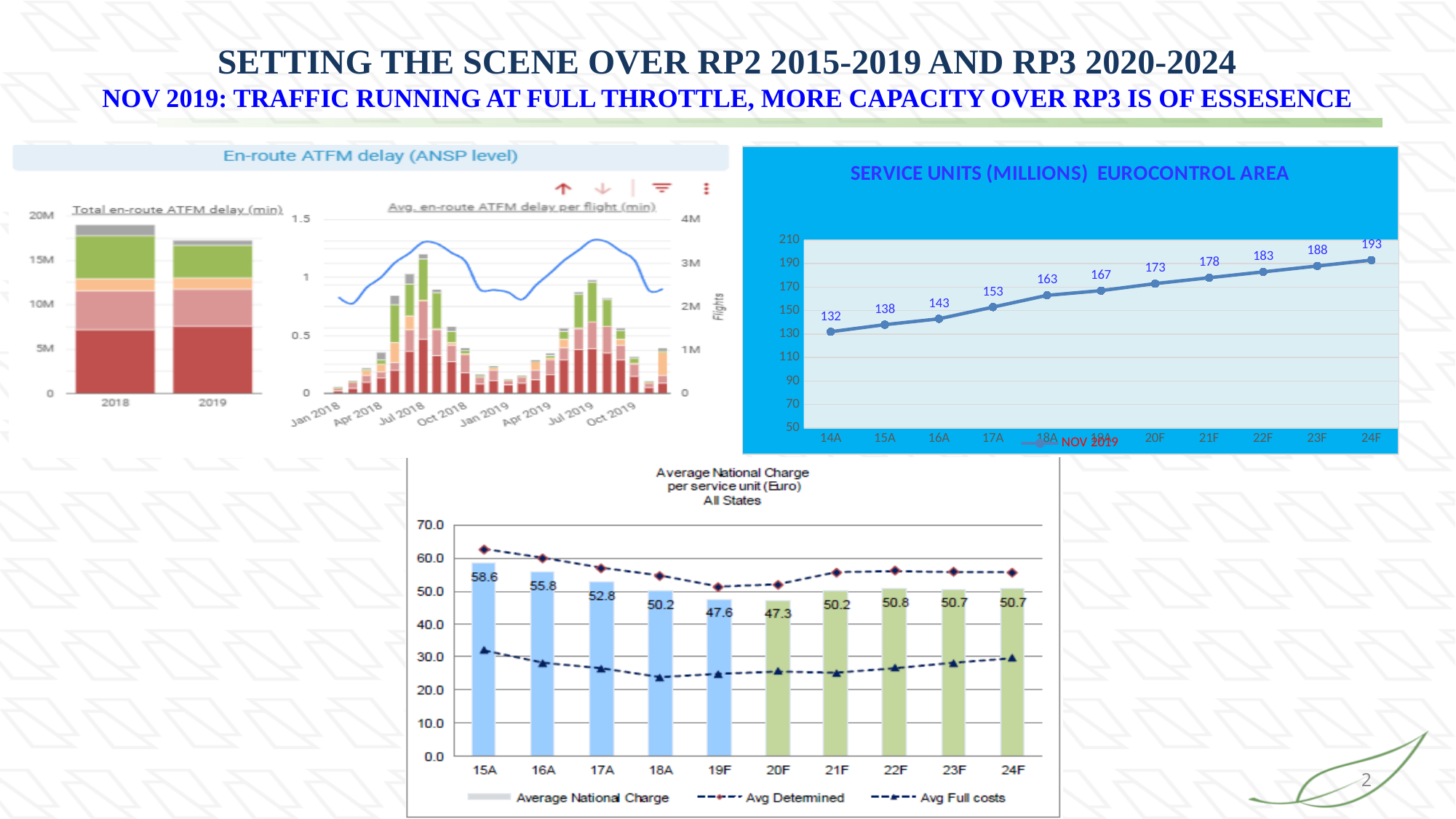
In the SERVICE UNITS (MILLIONS) EUROCONTROL AREA chart, what is the value for 14A? 132 In the Total en-route ATFM delay (min) chart at the top left, is the total for 2018 greater or less than 15M? greater In the Average National Charge per service unit chart, what is the difference between the Average National Charge for 15A and 16A? 2.8 In the SERVICE UNITS (MILLIONS) EUROCONTROL AREA chart, do the values rise or fall from 14A to 24F? rise In the Average National Charge per service unit chart, is the Avg Determined value for 15A greater or less than 60.0? greater In the Average National Charge per service unit chart, how many series does the legend list? 3 In the SERVICE UNITS (MILLIONS) EUROCONTROL AREA chart, what is the value for 24F? 193 In the SERVICE UNITS (MILLIONS) EUROCONTROL AREA chart, what is the difference between the values for 24F and 14A? 61 In the Average National Charge per service unit chart, which year has the lowest Average National Charge? 20F In the SERVICE UNITS (MILLIONS) EUROCONTROL AREA chart, how many data points are plotted? 11 In the Average National Charge per service unit chart, which is larger, the Average National Charge for 22F or for 19F? 22F In the Average National Charge per service unit chart, what is the Average National Charge for 15A? 58.6